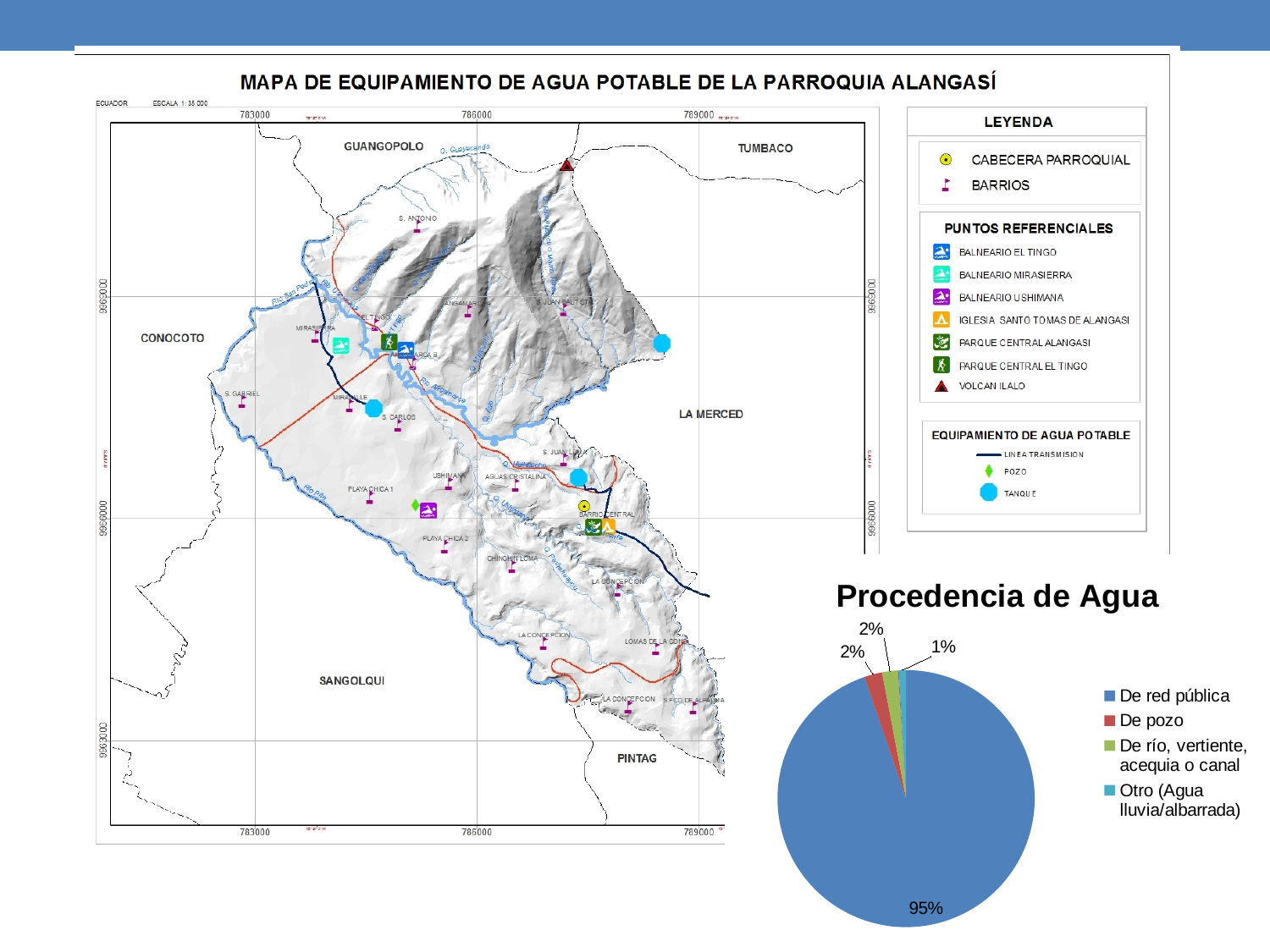
In the 'Procedencia de Agua' chart, which is larger: 'De red pública' or 'De río, vertiente, acequia o canal'? De red pública In the 'Procedencia de Agua' chart, what is the value for 'De pozo'? 2% How many entries does the legend of the 'Procedencia de Agua' chart list? 4 In the 'Procedencia de Agua' chart, what is the difference between 'De red pública' and 'De pozo'? 93% What is the title of the chart on the slide? Procedencia de Agua Which category has the smallest slice in the 'Procedencia de Agua' chart? Otro (Agua lluvia/albarrada) In the 'Procedencia de Agua' chart, what is the value for 'Otro (Agua lluvia/albarrada)'? 1% How many slices does the 'Procedencia de Agua' pie chart have? 4 What colour is the 'De red pública' slice in the 'Procedencia de Agua' chart? blue Which category has the largest slice in the 'Procedencia de Agua' chart? De red pública What kind of chart is the 'Procedencia de Agua' chart? pie chart In the 'Procedencia de Agua' chart, what share is 'De red pública'? 95%